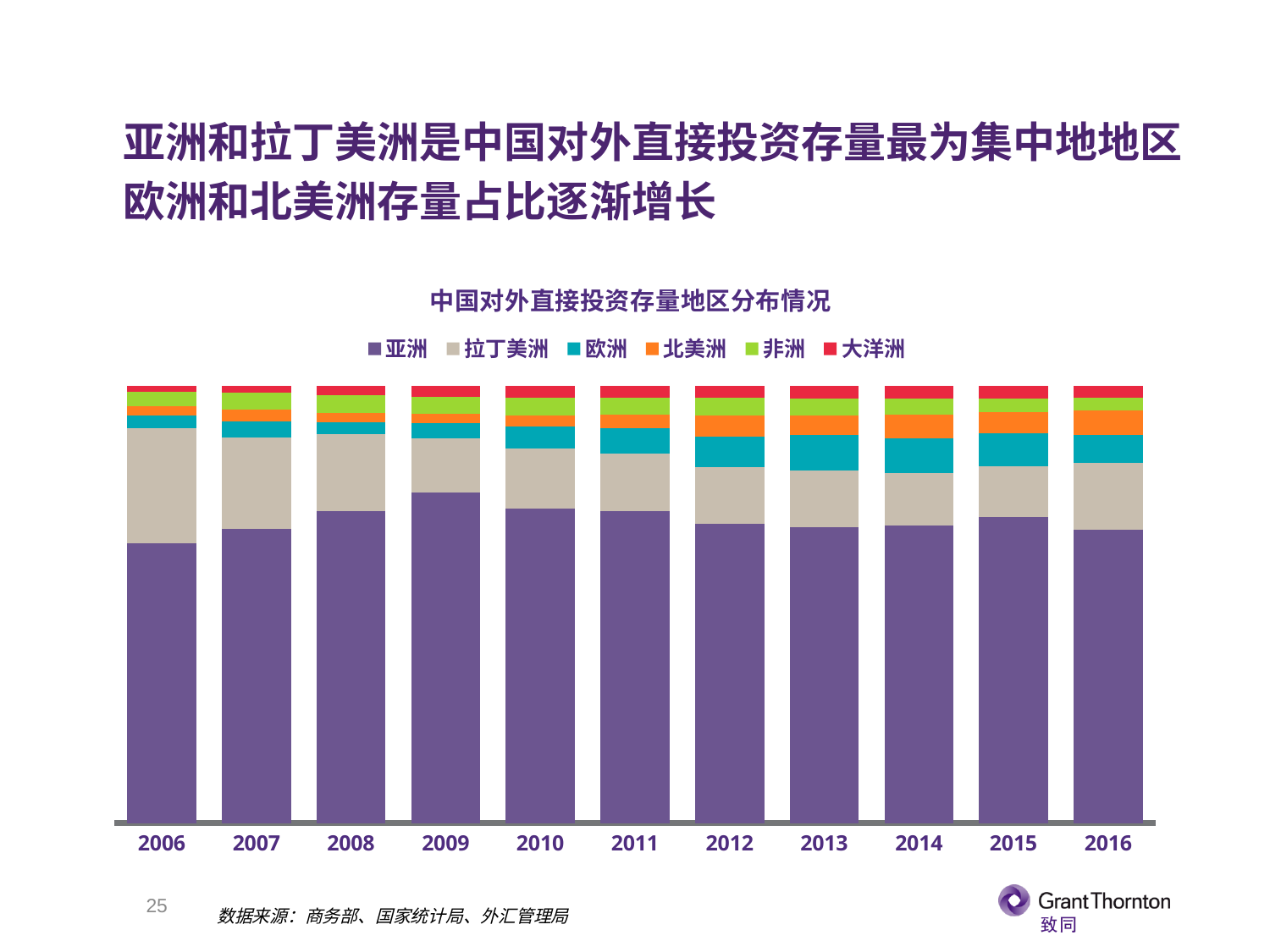
In which year is the share for 亚洲 the largest? 2009 Which series is plotted at the bottom of each stacked bar? 亚洲 What is the title of the chart? 中国对外直接投资存量地区分布情况 Which region accounts for the largest share of the stacked bar in 2016? 亚洲 In 2010, which is larger: the share for 亚洲 or the share for 拉丁美洲? 亚洲 Does the share for 欧洲 rise or fall from 2006 to 2016? rise How many years are shown along the x axis? 11 Which region accounts for the smallest share of the stacked bar in 2006? 大洋洲 How many series does the legend list? 6 In 2016, which is larger: the share for 欧洲 or the share for 大洋洲? 欧洲 What is the first year shown on the x axis? 2006 What kind of chart is shown on the slide? stacked bar chart